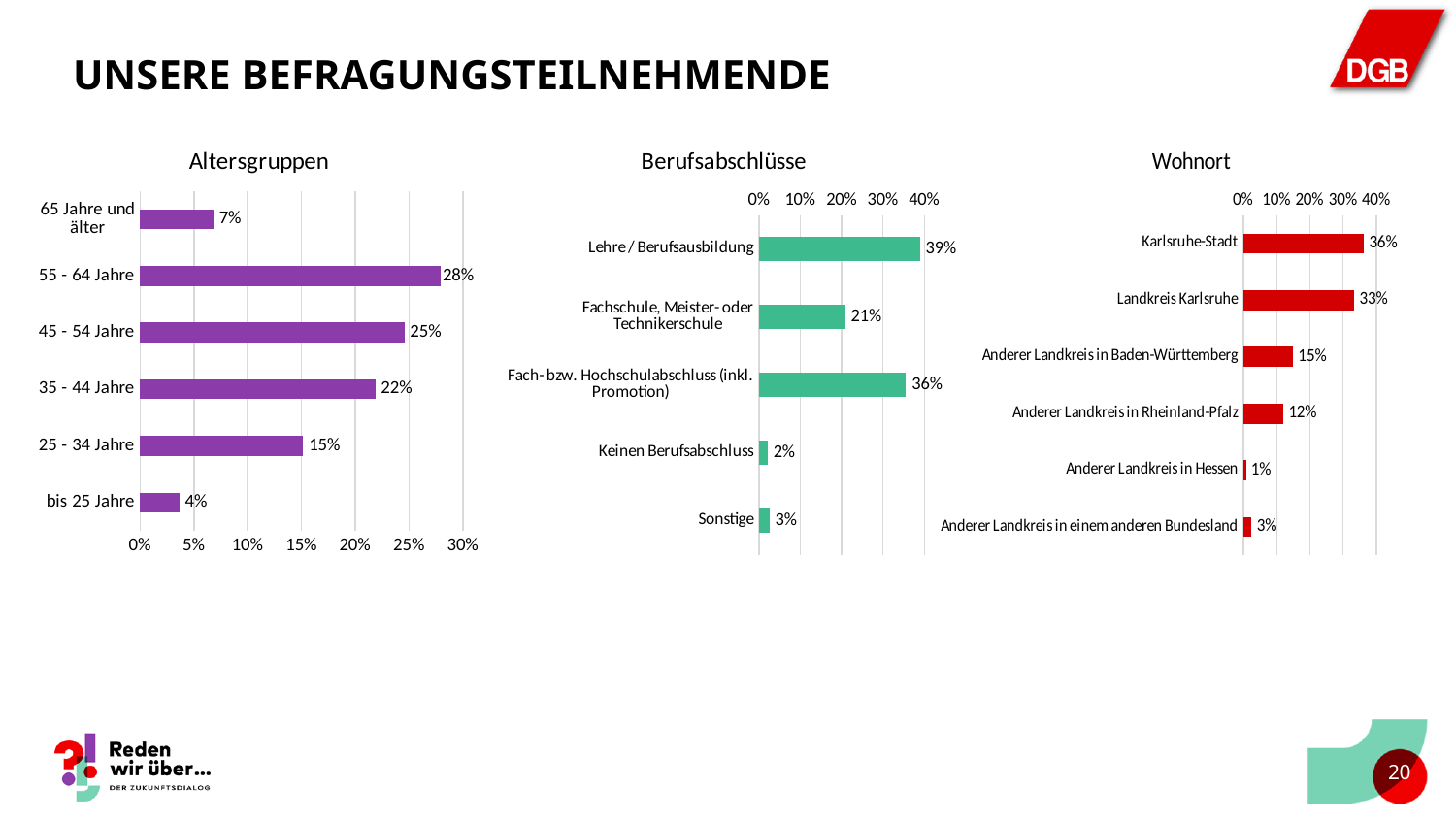
In the Wohnort chart, what is the difference between Karlsruhe-Stadt and Anderer Landkreis in Baden-Württemberg? 21% In the Altersgruppen chart, which age group has the lowest value? bis 25 Jahre In the Wohnort chart, what is the value for Landkreis Karlsruhe? 33% In the Berufsabschlüsse chart, what is the value for Fachschule, Meister- oder Technikerschule? 21% In the Wohnort chart, which category has the lowest value? Anderer Landkreis in Hessen In the Altersgruppen chart, what is the difference between 45 - 54 Jahre and 25 - 34 Jahre? 10% What type of chart is the Wohnort chart? Bar chart In the Berufsabschlüsse chart, which category has the highest value? Lehre / Berufsausbildung What colour are the bars in the Berufsabschlüsse chart? Green In the Berufsabschlüsse chart, which is larger: Keinen Berufsabschluss or Sonstige? Sonstige How many age groups are shown in the Altersgruppen chart? 6 In the Altersgruppen chart, what is the value for 55 - 64 Jahre? 28%